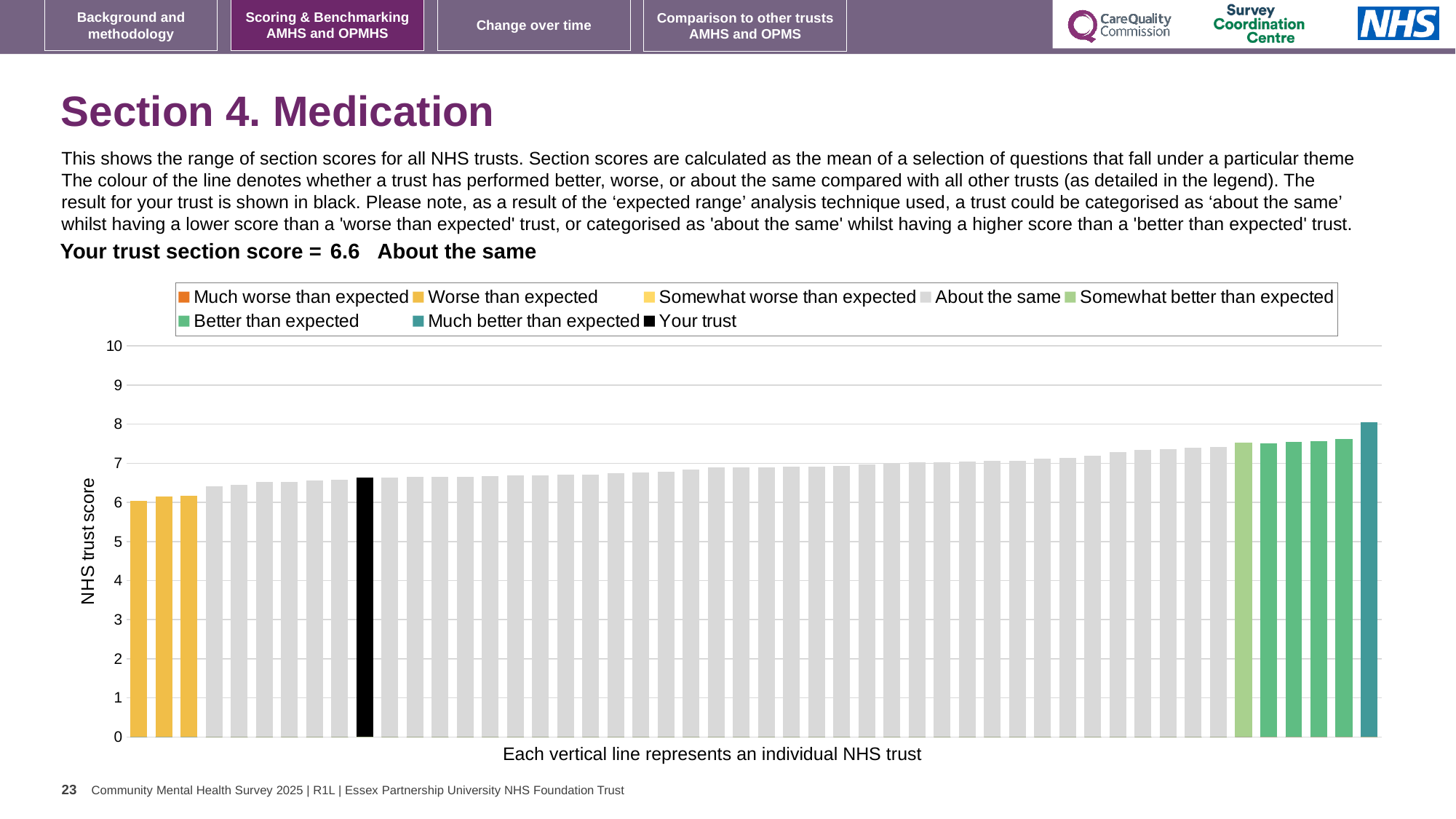
Is the value of the shortest bar in the chart greater or less than 7? less How many bars are coloured as 'Worse than expected'? 3 Do the bar values rise or fall moving from left to right along the x axis? Rise Which legend category does the tallest bar belong to? Much better than expected Which legend category does the shortest bar belong to? Worse than expected What is the section score for your trust shown on the slide? 6.6 How many entries does the chart legend list? 8 What kind of chart is shown on the slide? Bar chart Is the value of the black 'Your trust' bar greater or less than 5? greater Which performance category is your trust placed in for Section 4. Medication? About the same Is the value of the tallest bar in the chart greater or less than 7? greater What is the label on the vertical axis of the chart? NHS trust score